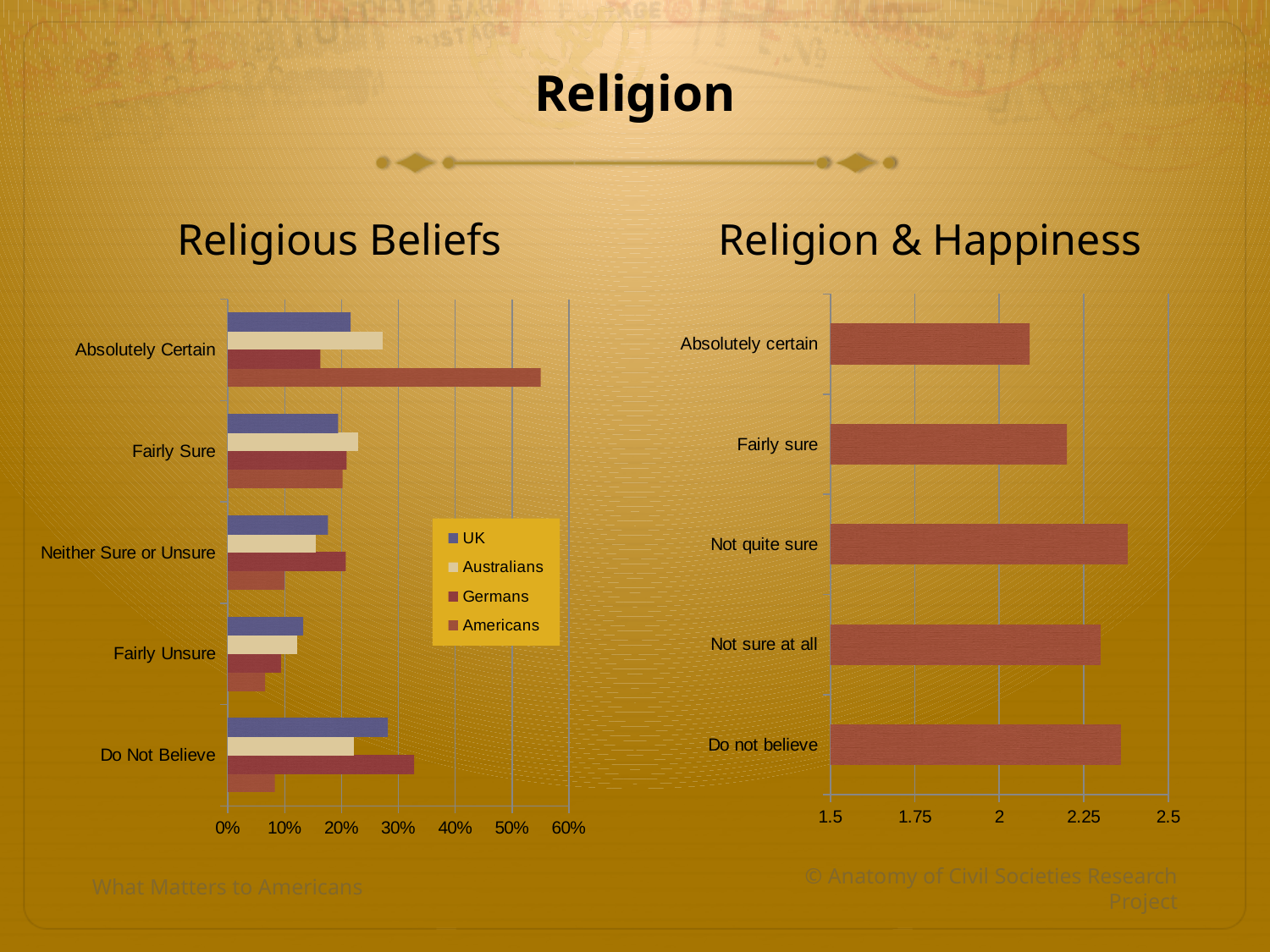
In the "Religious Beliefs" chart, which category has the highest value for Americans? Absolutely Certain How many categories are shown on the "Religious Beliefs" chart? 5 What type of chart is the "Religious Beliefs" chart? bar chart How many categories are shown on the "Religion & Happiness" chart? 5 In the "Religion & Happiness" chart, is the value for Not quite sure greater or less than 2.25? greater In the "Religious Beliefs" chart, is the value for Americans in the Absolutely Certain category greater or less than 50%? greater In the "Religious Beliefs" chart, which is larger for the Absolutely Certain category: the value for Americans or the value for Germans? Americans How many series does the legend of the "Religious Beliefs" chart list? 4 In the "Religious Beliefs" chart, is the value for Germans in the Do Not Believe category greater or less than 30%? greater In the "Religion & Happiness" chart, which category has the lowest value? Absolutely certain In the "Religious Beliefs" chart, which series is listed last in the legend? Americans